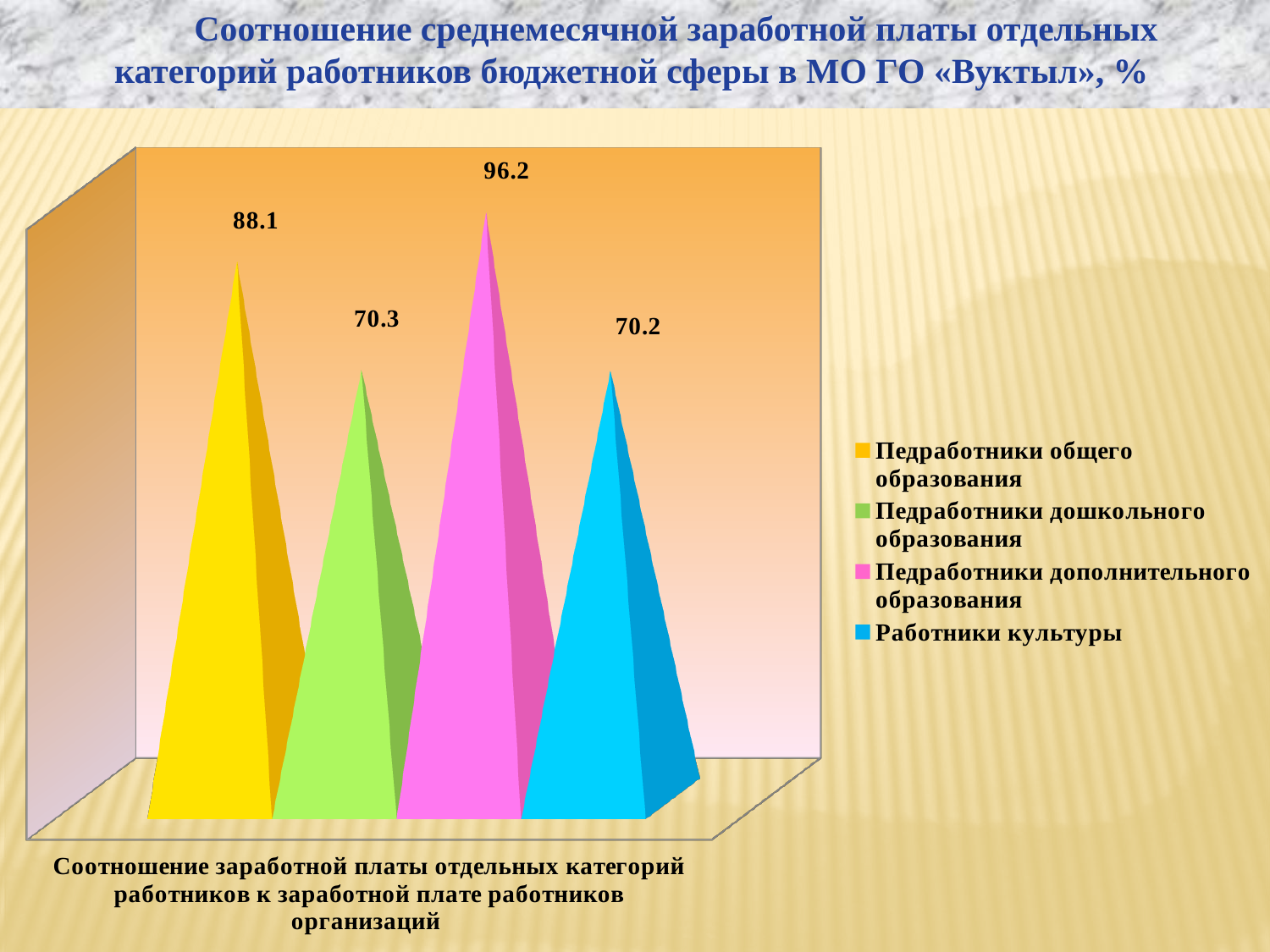
Which series has the highest value? Педработники дополнительного образования What is the label shown below the chart's category axis? Соотношение заработной платы отдельных категорий работников к заработной плате работников организаций What is the value for Педработники дополнительного образования? 96.2 Which is larger, the value for Педработники дополнительного образования or the value for Работники культуры? Педработники дополнительного образования What is the difference between the values for Педработники общего образования and Педработники дошкольного образования? 17.8 What kind of chart is shown on the slide? Bar chart What is the value for Работники культуры? 70.2 What colour represents Работники культуры in the chart? Blue What is the value for Педработники дошкольного образования? 70.3 What is the value for Педработники общего образования? 88.1 How many series does the legend list? 4 What is the difference between the values for Педработники дополнительного образования and Педработники общего образования? 8.1